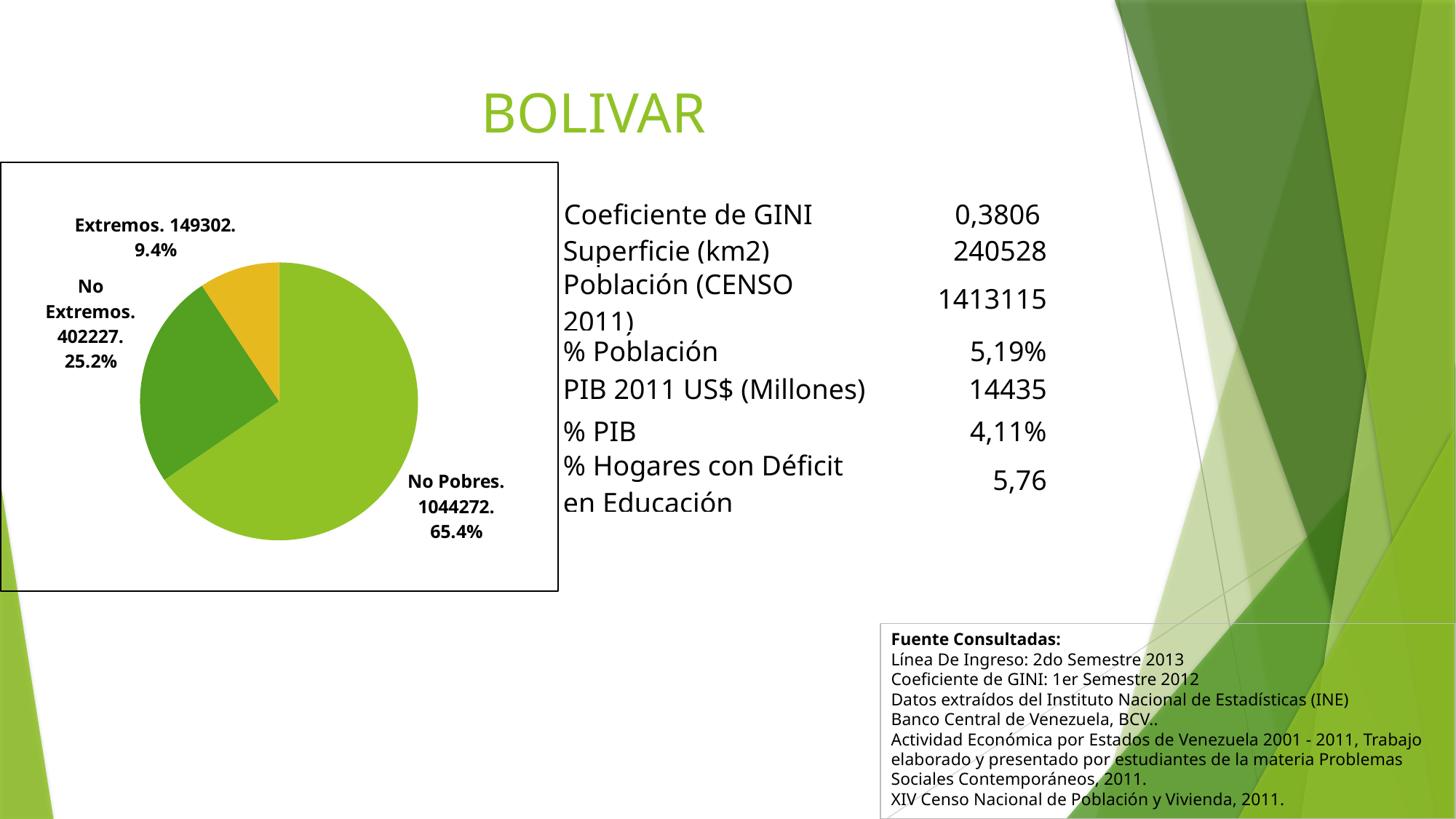
What kind of chart is shown on the slide? pie chart What is the value for No Extremos in the pie chart? 402227 What is the difference between the No Extremos value and the Extremos value in the pie chart? 252925 What is the value for No Pobres in the pie chart? 1044272 What share of the pie does the Extremos slice represent? 9.4% How many slices does the pie chart have? 3 What share of the pie does the No Pobres slice represent? 65.4% What share of the pie does the No Extremos slice represent? 25.2% Which slice of the pie chart is the largest? No Pobres Which slice of the pie chart is the smallest? Extremos What is the value for Extremos in the pie chart? 149302 Which is larger in the pie chart, No Extremos or Extremos? No Extremos